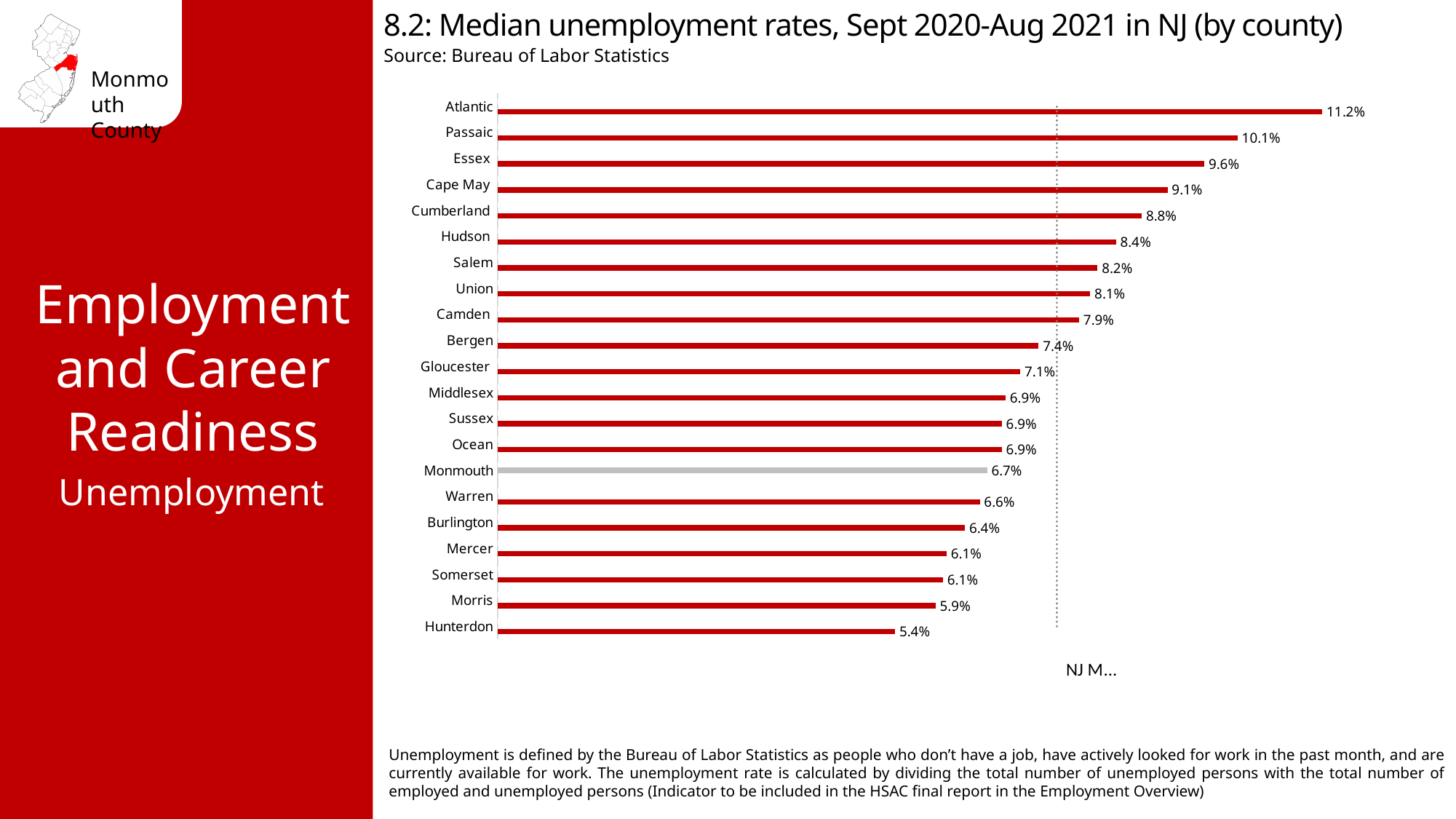
Which county has the lowest median unemployment rate? Hunterdon What is the difference between the median unemployment rates of Atlantic and Hunterdon counties? 5.8% What kind of chart is used to show the median unemployment rates? Bar chart What is the median unemployment rate for Cape May county? 9.1% Which county has the highest median unemployment rate? Atlantic Which county's bar is shown in grey instead of red? Monmouth How many counties are shown in the chart? 21 Which county has a higher median unemployment rate, Passaic or Essex? Passaic What is the difference between the median unemployment rates of Monmouth and Ocean counties? 0.2% What is the median unemployment rate for Monmouth county? 6.7% What is the source cited for the chart? Bureau of Labor Statistics What is the median unemployment rate for Hudson county? 8.4%